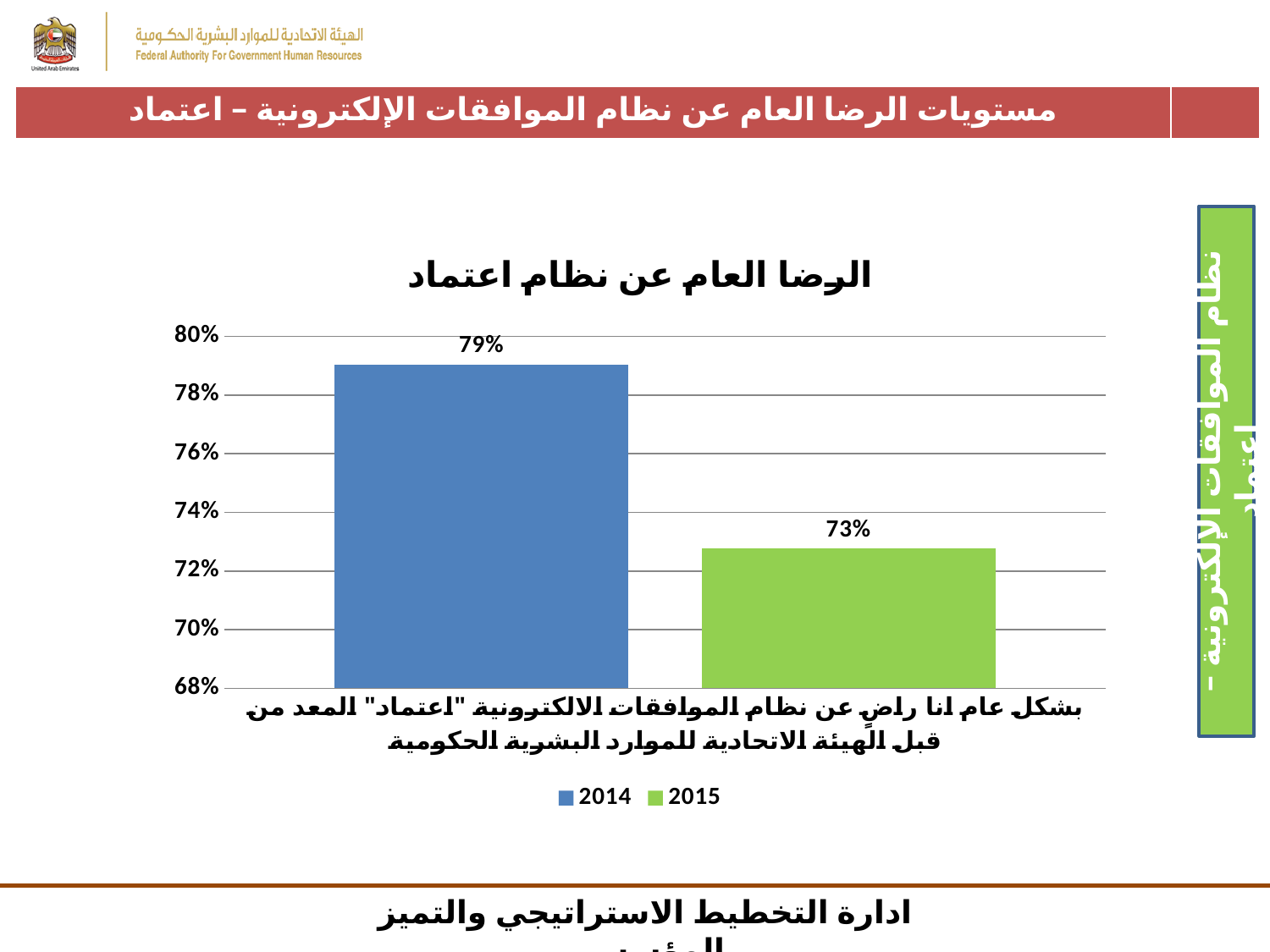
What is the value for 2014? 79% Which series has the lowest value? 2015 What is the value for 2015? 73% What kind of chart is shown on the slide? bar chart Which series has the higher value, 2014 or 2015? 2014 What is the difference between the 2014 and 2015 values? 6% How many series does the legend list? 2 Is the value for 2014 greater or less than 78%? greater What colour is the bar for 2015? green Does the value rise or fall from 2014 to 2015? fall What is the title of the chart? الرضا العام عن نظام اعتماد Is the value for 2015 greater or less than 74%? less